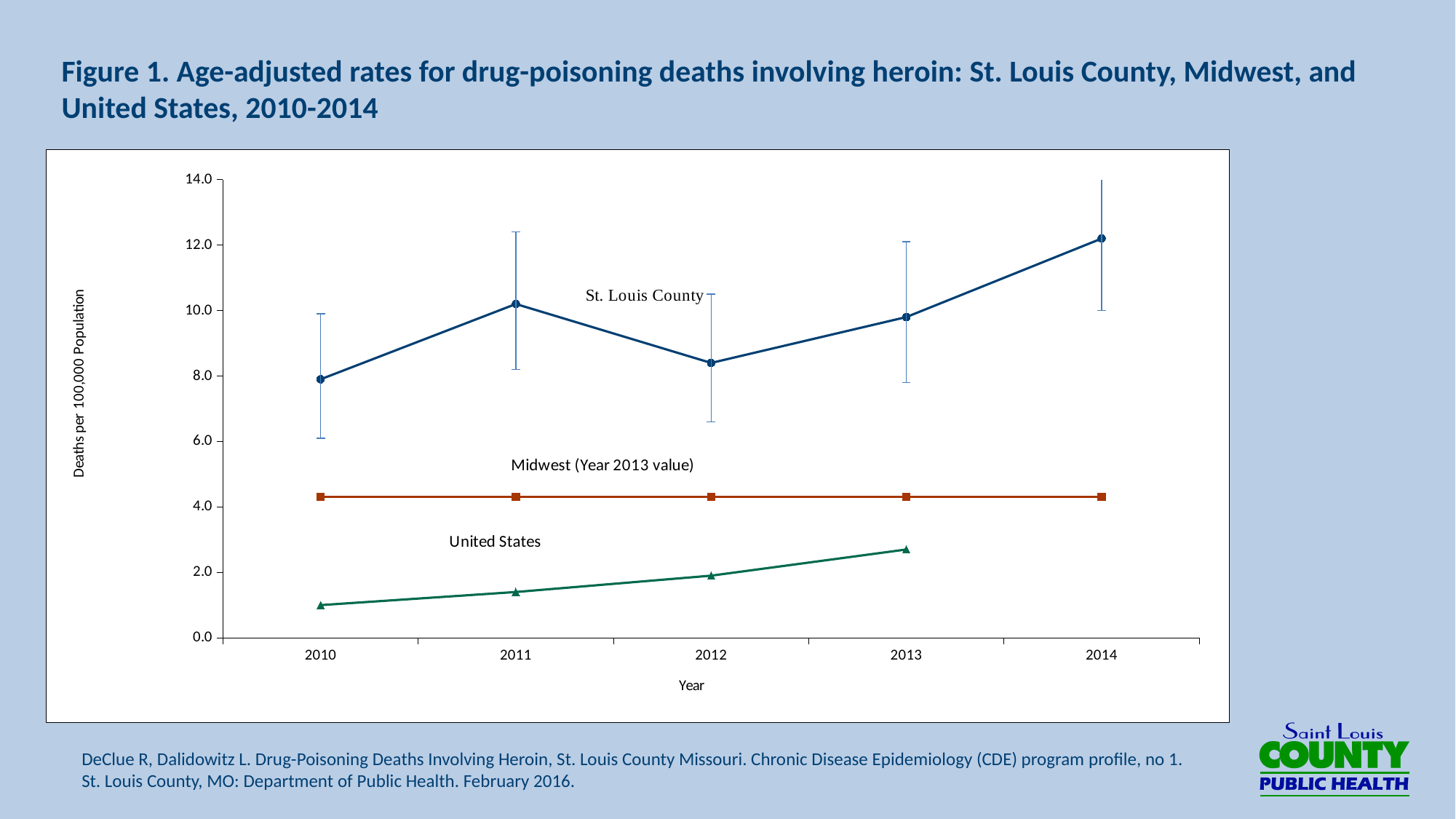
Is the St. Louis County value for 2014 greater or less than 10.0? greater Is the United States value for 2013 greater or less than 2.0? greater Is the Midwest (Year 2013 value) line greater or less than 6.0? less In which year is the St. Louis County rate highest? 2014 What type of chart is shown on the slide? line chart How many data series are plotted on the chart? 3 In which year is the United States rate highest? 2013 Does the United States rate rise or fall from 2010 to 2013? rise How many years are shown on the x axis? 5 Which is larger in 2010: the St. Louis County rate or the Midwest rate? St. Louis County In which year is the St. Louis County rate lowest? 2010